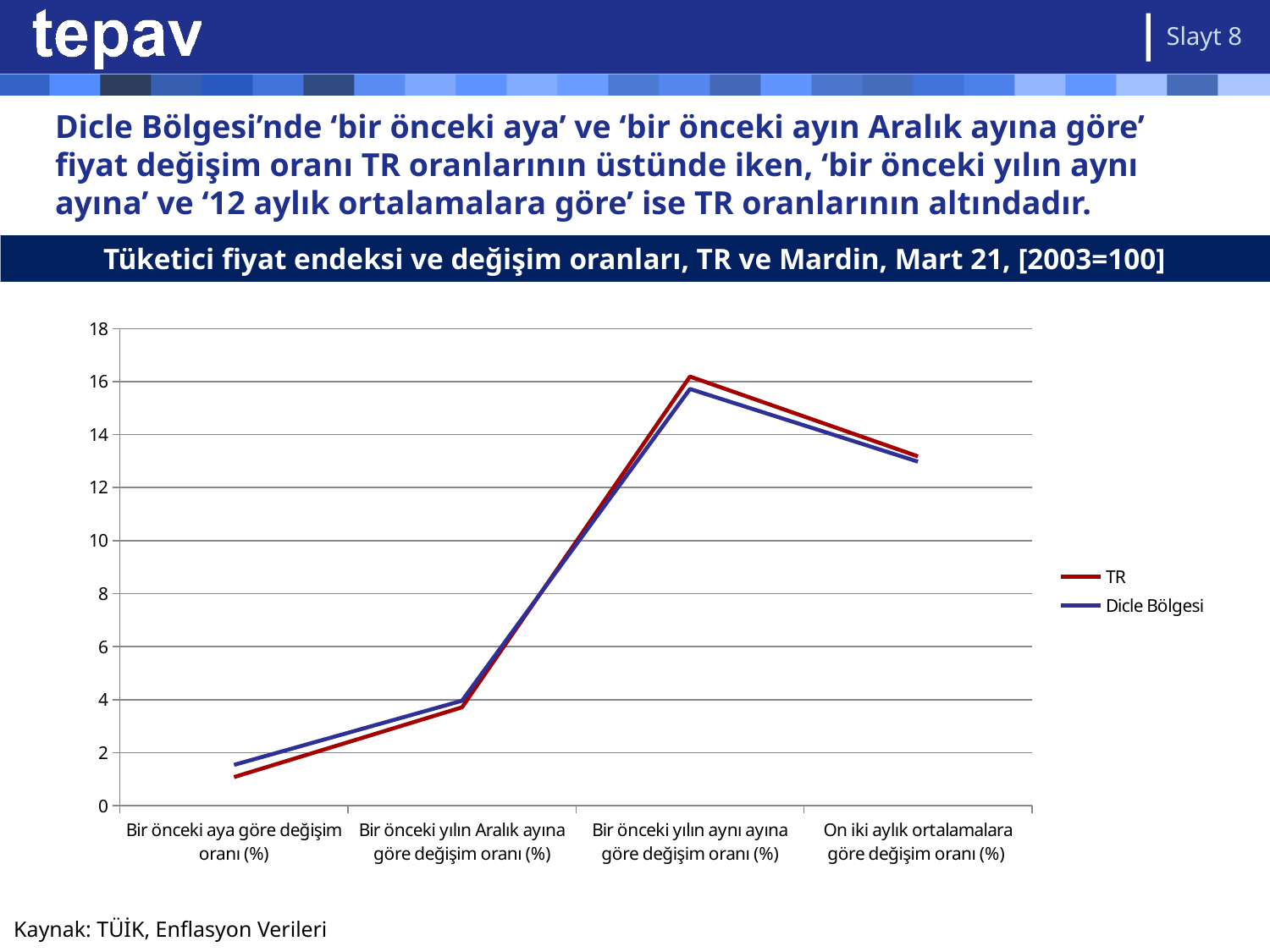
How many series does the legend list? 2 How many categories are shown on the x axis? 4 Does the TR line rise or fall between 'Bir önceki yılın aynı ayına göre değişim oranı (%)' and 'On iki aylık ortalamalara göre değişim oranı (%)'? fall For the TR series, which category has the highest value? Bir önceki yılın aynı ayına göre değişim oranı (%) Is the Dicle Bölgesi value for 'Bir önceki aya göre değişim oranı (%)' greater or less than 2? less Is the TR value for 'Bir önceki yılın aynı ayına göre değişim oranı (%)' greater or less than 14? greater Which colour is used for the Dicle Bölgesi line? blue For 'Bir önceki yılın aynı ayına göre değişim oranı (%)', which series has the larger value, TR or Dicle Bölgesi? TR Is the TR value for 'On iki aylık ortalamalara göre değişim oranı (%)' greater or less than 12? greater For 'Bir önceki aya göre değişim oranı (%)', which series has the larger value, TR or Dicle Bölgesi? Dicle Bölgesi For the Dicle Bölgesi series, which category has the lowest value? Bir önceki aya göre değişim oranı (%) What kind of chart is shown on the slide? line chart